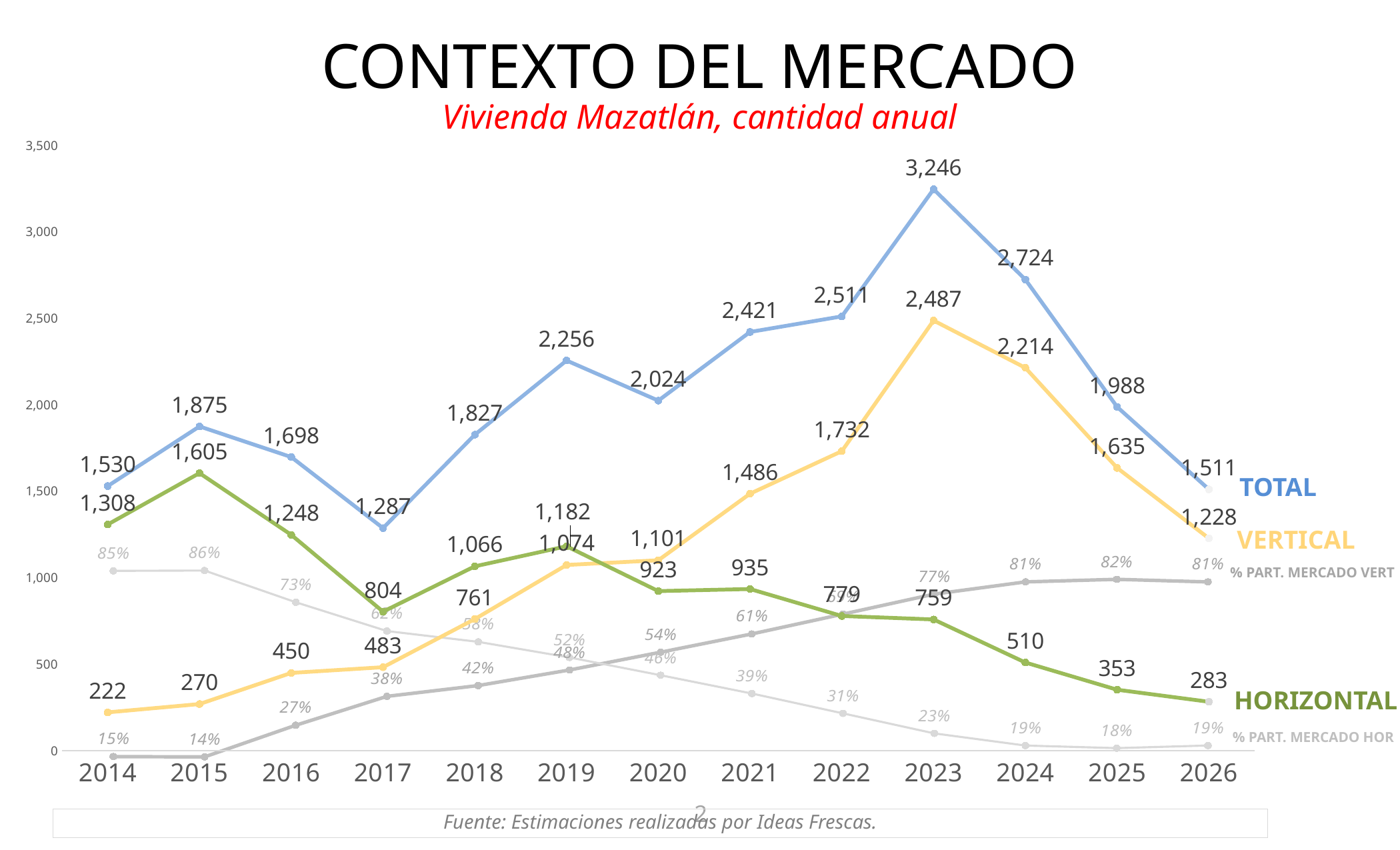
What is the TOTAL value for 2023? 3,246 What is the HORIZONTAL value for 2017? 804 How many years are plotted on the x axis? 13 Does the HORIZONTAL series rise or fall from 2023 to 2026? Fall In which year is the HORIZONTAL series at its lowest? 2026 What is the VERTICAL value for 2018? 761 What is the difference between the TOTAL values for 2023 and 2024? 522 In 2020, which is larger, the VERTICAL value or the HORIZONTAL value? VERTICAL In which year does the TOTAL series reach its highest value? 2023 What is the red subtitle of the chart? Vivienda Mazatlán, cantidad anual What is the % PART. MERCADO HOR value for 2014? 85% What kind of chart is shown on the slide? Line chart